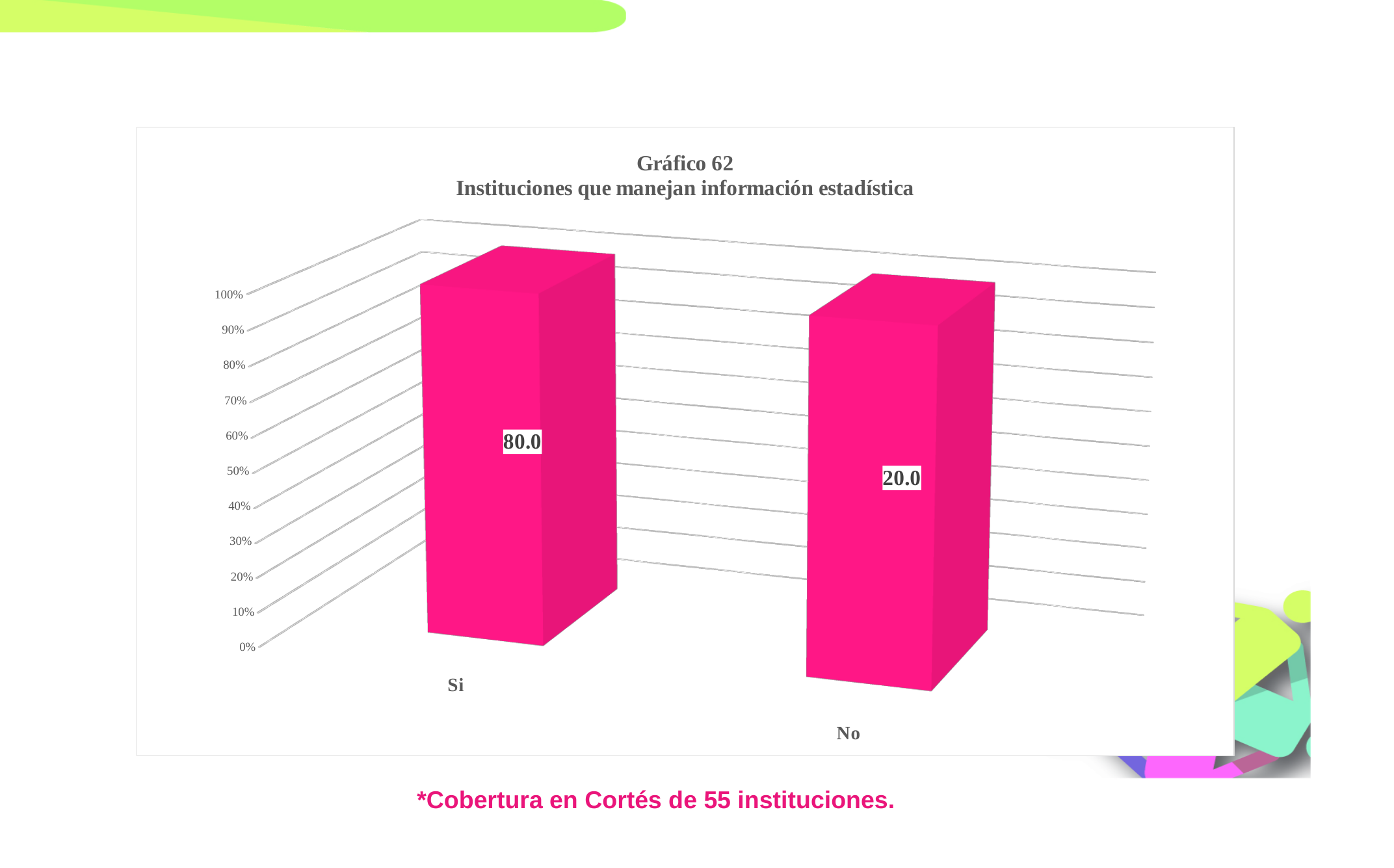
Which is larger, the value for Si or the value for No? Si Which category has the lowest value? No What kind of chart is shown on the slide? bar chart What colour are the bars in the chart? pink Is the value for No greater or less than 30%? less What is the difference between the values for Si and No? 60.0 Is the value for Si greater or less than 50%? greater What is the value for Si? 80.0 Which category has the highest value? Si What is the value for No? 20.0 How many categories are shown in the chart? 2 What is the title of the chart? Gráfico 62 Instituciones que manejan información estadística